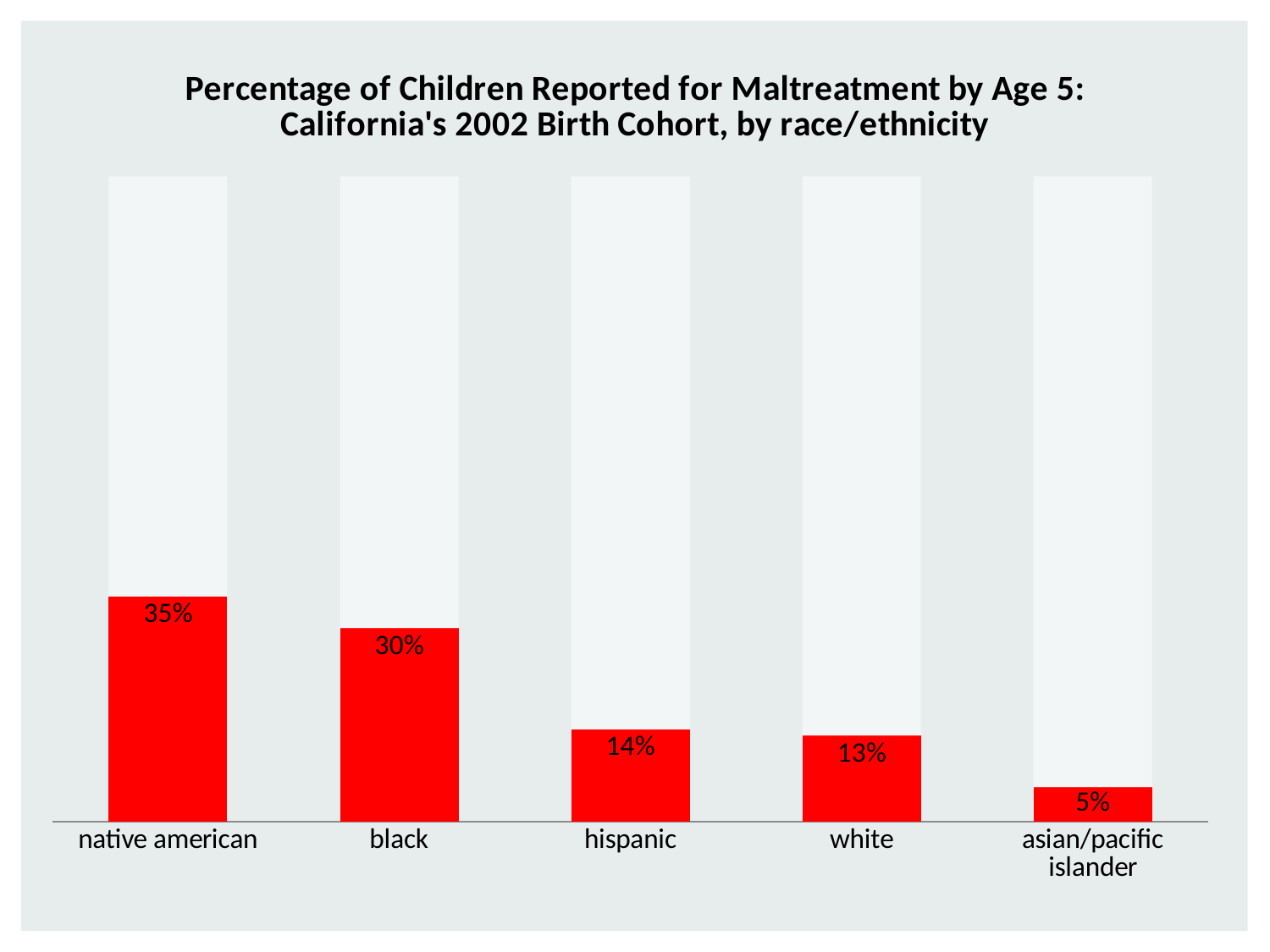
Which group has a larger value, black or hispanic? black What is the value shown for black children? 30% What percentage of native american children were reported for maltreatment by age 5? 35% What kind of chart is shown on the slide? bar chart What is the value shown for asian/pacific islander children? 5% What is the difference in percentage points between native american and black children? 5% Which race/ethnicity group has the highest percentage of children reported for maltreatment? native american What is the difference in percentage points between hispanic and asian/pacific islander children? 9% Which race/ethnicity group has the lowest percentage of children reported for maltreatment? asian/pacific islander What is the value shown for hispanic children? 14% What is the value shown for white children? 13% How many race/ethnicity categories are shown in the chart? 5